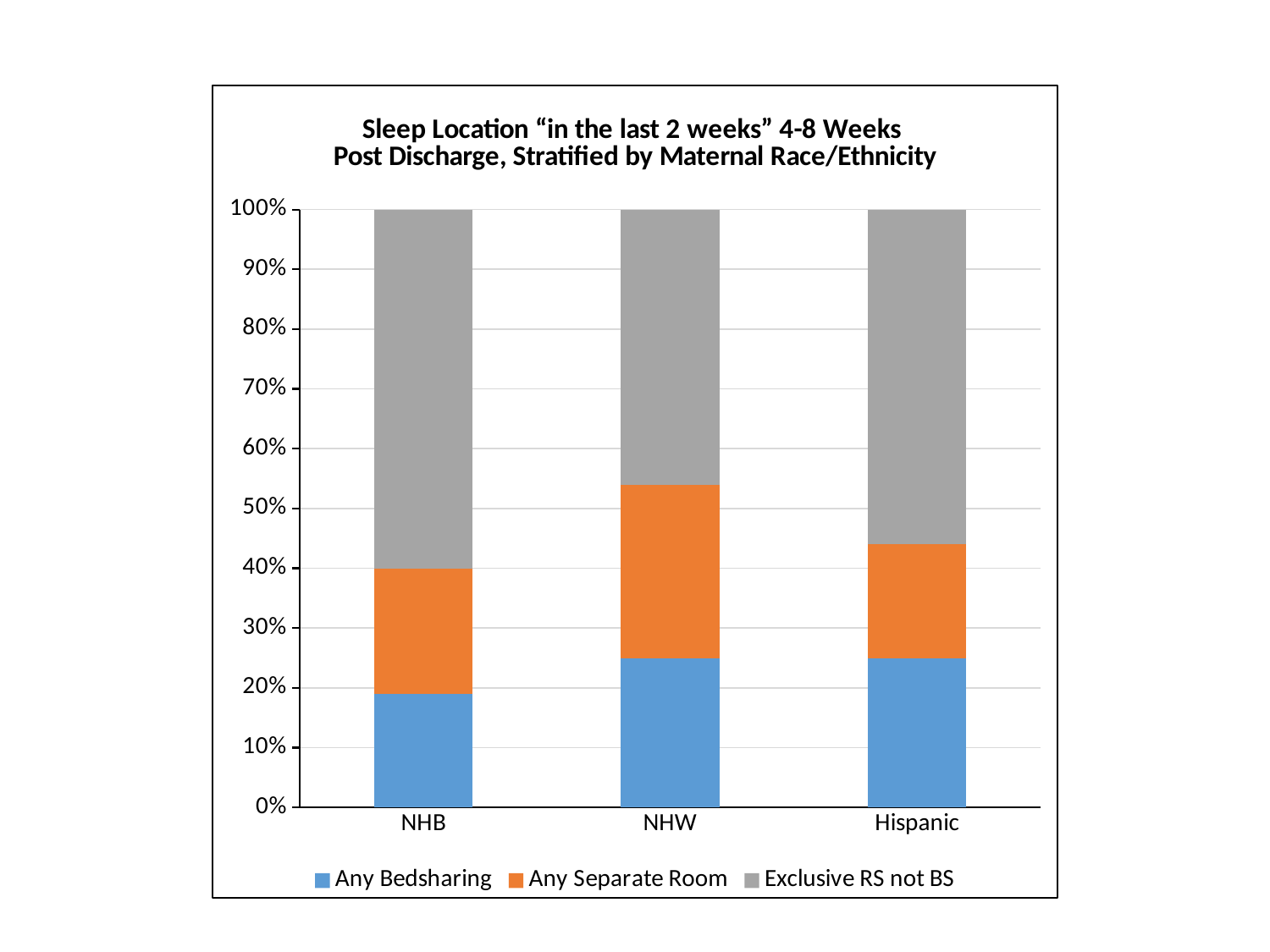
Which category has the largest Exclusive RS not BS segment? NHB What kind of chart is shown on the slide? Stacked bar chart Is the Exclusive RS not BS segment larger for NHB or for NHW? NHB Which category has the largest Any Separate Room segment? NHW Which category has the smallest Any Bedsharing segment? NHB Which colour represents Any Separate Room in the legend? Orange Is the Any Bedsharing value for NHW greater or less than 20%? greater How many series does the legend list? 3 Is the Any Bedsharing segment larger for NHB or for NHW? NHW How many maternal race/ethnicity categories are shown on the x axis? 3 Is the Exclusive RS not BS value for NHW greater or less than 50%? less Is the Any Bedsharing value for NHB greater or less than 30%? less